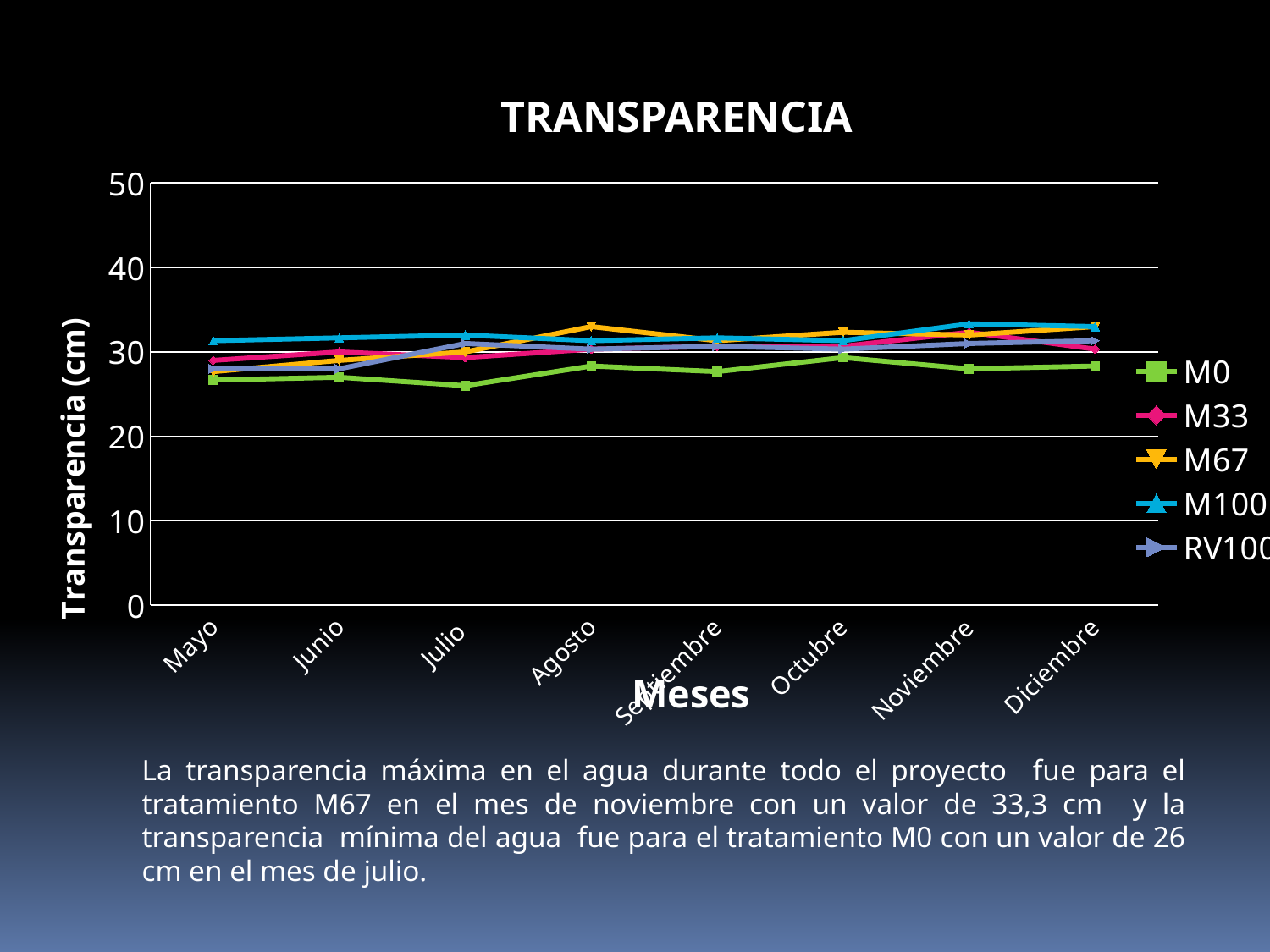
Is the value for M0 in Mayo greater or less than 30? less In Julio, which is larger, the value for M0 or the value for M100? M100 Is the value for M100 in Noviembre greater or less than 40? less What is the label of the vertical axis? Transparencia (cm) How many months are shown along the x axis? 8 What kind of chart is shown on the slide? line chart Does the value for M67 rise or fall from Mayo to Agosto? rise Which series has the lowest value in Julio? M0 Is the value for M0 in Julio greater or less than 30? less How many series does the legend list? 5 What is the title of the chart? TRANSPARENCIA